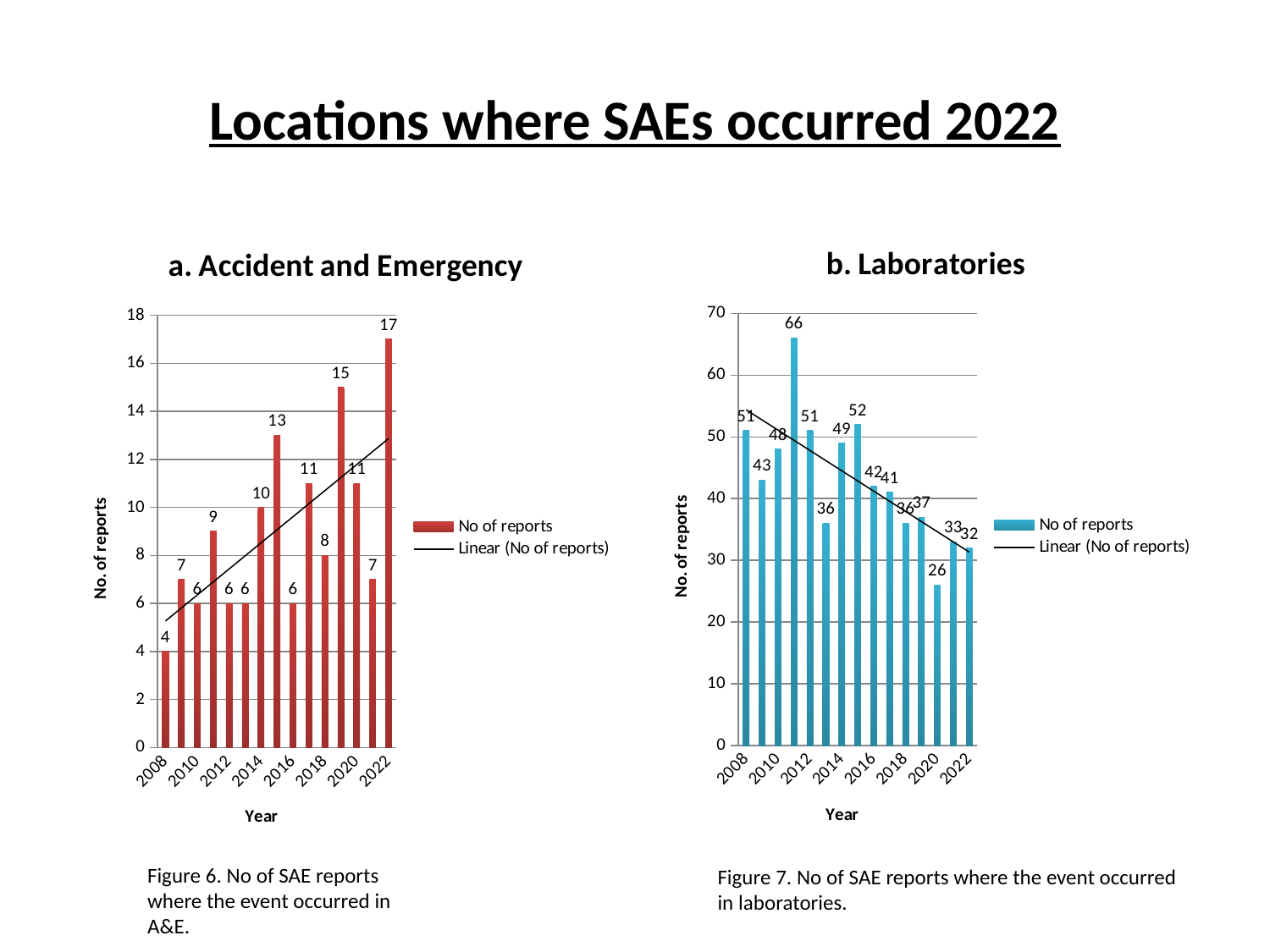
In the Accident and Emergency chart, which year has more reports, 2016 or 2018? 2018 In the Laboratories chart, what is the difference between the number of reports in 2008 and in 2022? 19 What type of chart is the Accident and Emergency chart? bar chart In the Laboratories chart, what is the highest number of reports shown? 66 In the Laboratories chart, how many SAE reports were there in 2020? 26 In the Accident and Emergency chart, how many SAE reports were there in 2022? 17 Over the years shown, do the values in the Laboratories chart generally rise or fall? fall In the Accident and Emergency chart, what is the highest number of reports shown? 17 How many bars are plotted in the Laboratories chart? 15 In the Accident and Emergency chart, how many SAE reports were there in 2008? 4 In the Laboratories chart, how many SAE reports were there in 2014? 49 In the Laboratories chart, which year has the lowest number of reports? 2020